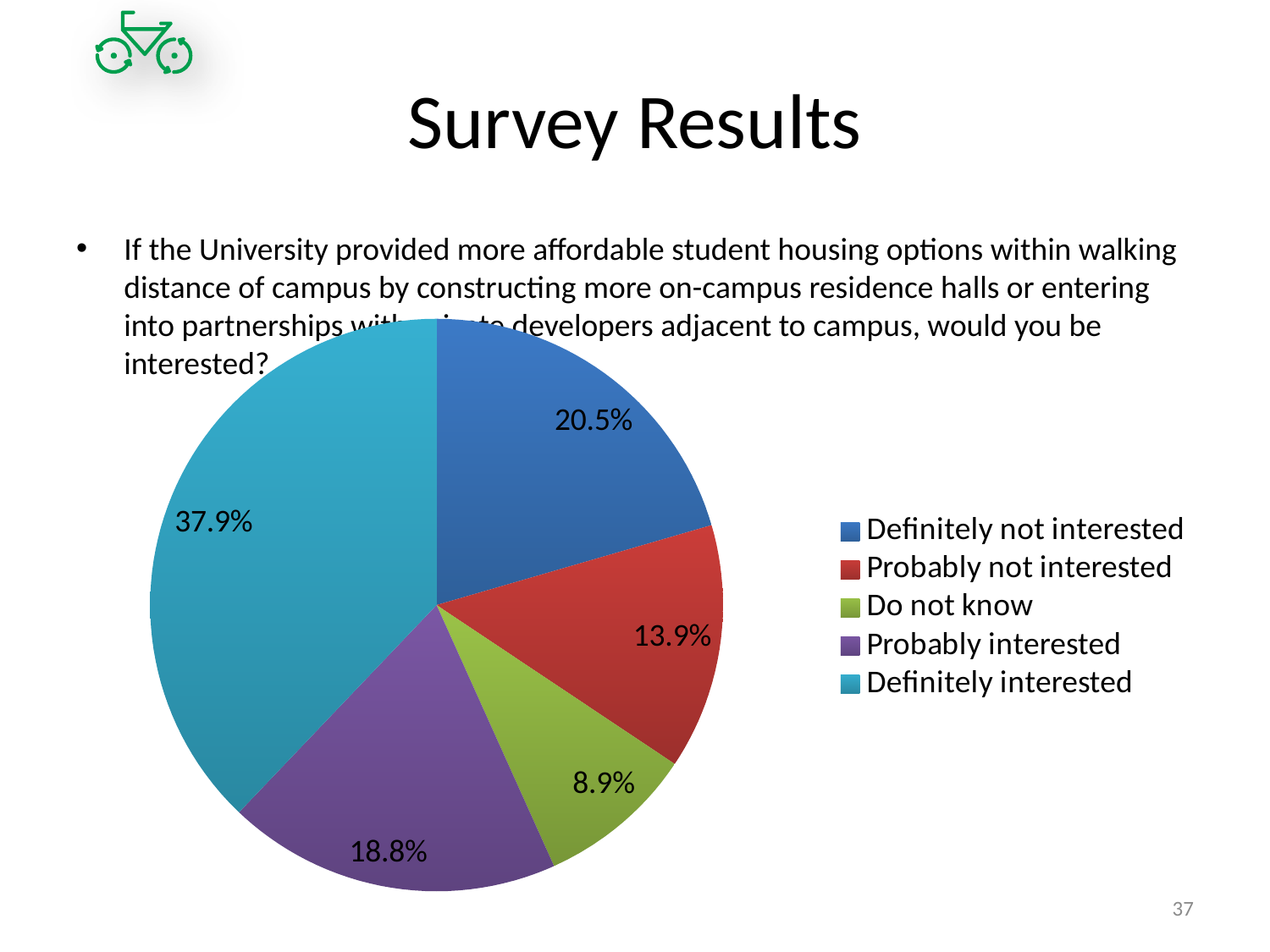
What percentage of respondents were "Probably interested"? 18.8% Which response category has the smallest share of the pie? Do not know Which response category has the largest share of the pie? Definitely interested What percentage of respondents were "Definitely interested"? 37.9% How many response categories does the legend list? 5 What percentage of respondents were "Probably not interested"? 13.9% What is the difference in percentage points between "Definitely interested" and "Definitely not interested"? 17.4 What percentage of respondents answered "Do not know"? 8.9% What colour is the "Do not know" slice? green What kind of chart is shown on the slide? pie chart What percentage of respondents were "Definitely not interested"? 20.5% Which is larger: the share for "Probably interested" or the share for "Probably not interested"? Probably interested